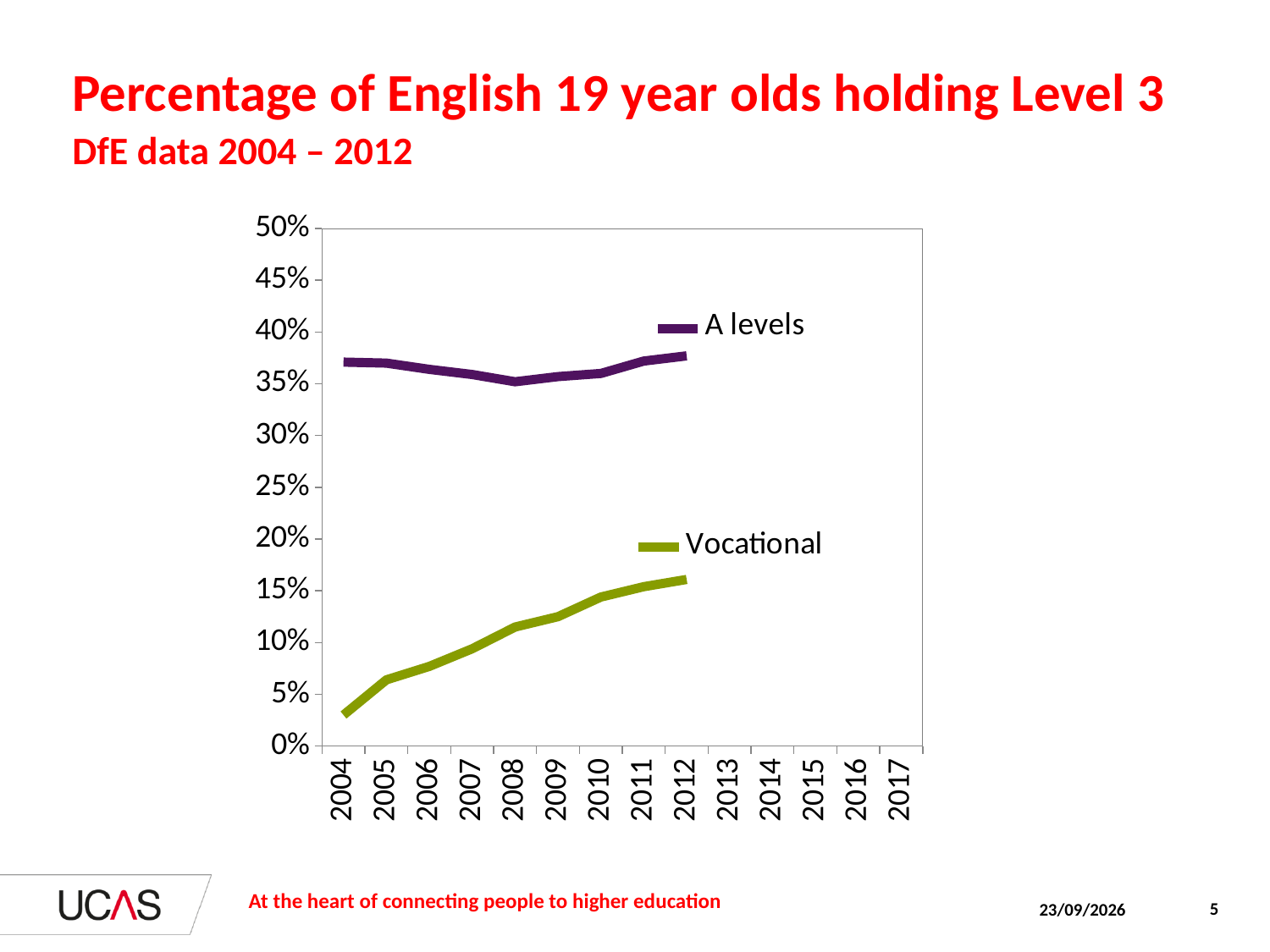
Do the Vocational values rise or fall from 2004 to 2012? rise Which series has the larger value in 2012, A levels or Vocational? A levels In which year is the Vocational series at its lowest? 2004 In which year is the Vocational series at its highest? 2012 How many series does the legend list? 2 Is the value for A levels in 2004 greater or less than 35%? greater Is the value for Vocational in 2004 greater or less than 5%? less What are the two series named in the legend? A levels and Vocational What is the title of the chart on the slide? Percentage of English 19 year olds holding Level 3 Is the value for Vocational in 2012 greater or less than 10%? greater What kind of chart is shown on the slide? line chart